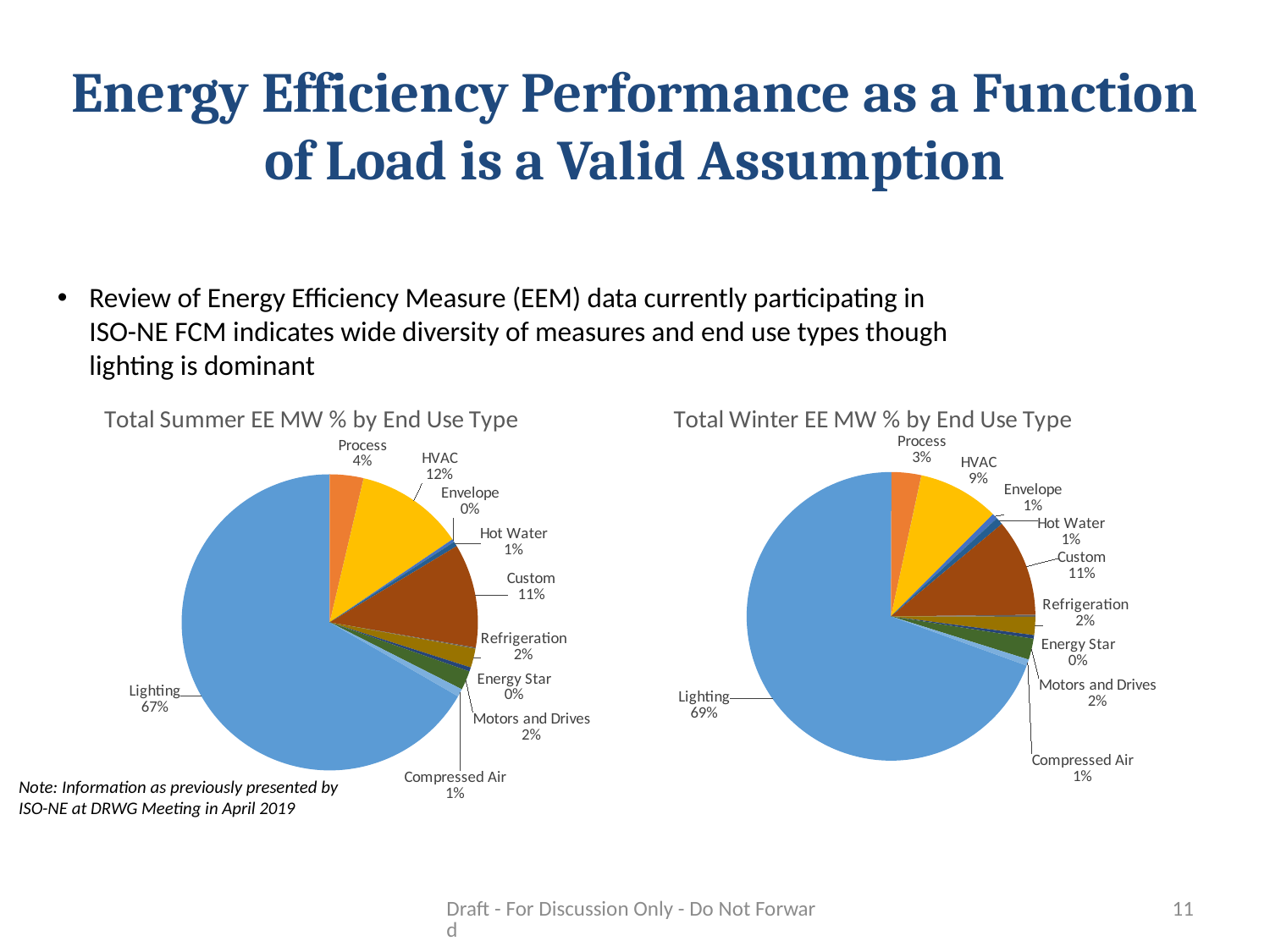
In the 'Total Summer EE MW % by End Use Type' chart, which end use type has the largest share? Lighting In the 'Total Summer EE MW % by End Use Type' chart, which is larger, the share for HVAC or the share for Custom? HVAC In the 'Total Summer EE MW % by End Use Type' chart, what is the share for HVAC? 12% In the 'Total Winter EE MW % by End Use Type' chart, what is the share for HVAC? 9% What kind of chart is 'Total Winter EE MW % by End Use Type'? Pie chart In the 'Total Winter EE MW % by End Use Type' chart, which end use type has the largest share? Lighting What is the difference between the HVAC share in the summer chart and the HVAC share in the winter chart? 3% In the 'Total Winter EE MW % by End Use Type' chart, what share does Lighting have? 69% In the 'Total Summer EE MW % by End Use Type' chart, what share does Lighting have? 67% How many end use type categories are shown in the 'Total Summer EE MW % by End Use Type' chart? 10 In the 'Total Winter EE MW % by End Use Type' chart, what is the share for Custom? 11% What is the title of the chart on the left side of the slide? Total Summer EE MW % by End Use Type